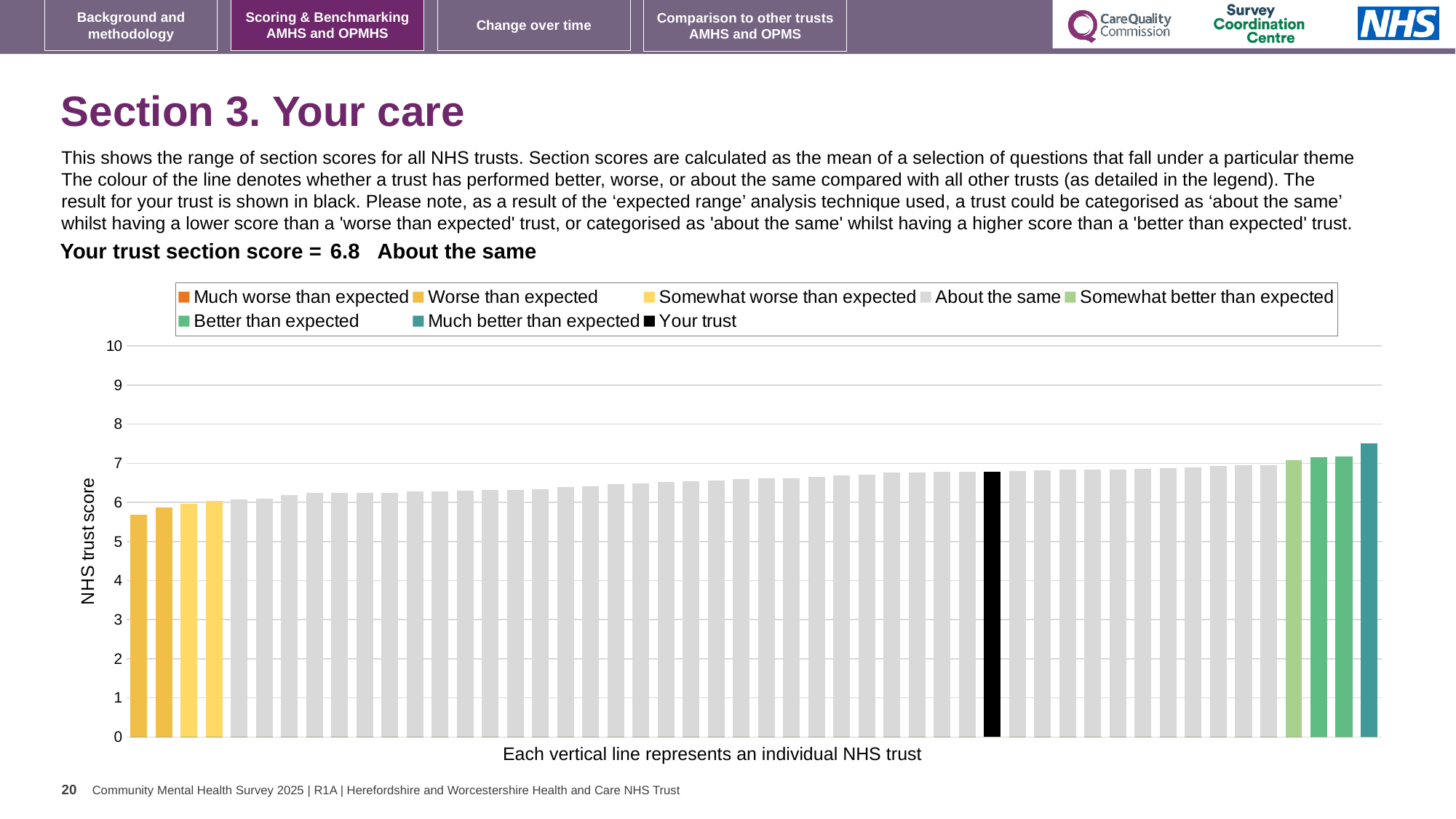
Do the bar values rise or fall from left to right along the x axis? rise What colour is the bar representing your trust? black How many entries does the chart legend list? 8 Is the value for your trust greater or less than 5? greater Which benchmarking category is your trust placed in for Section 3? About the same Is the value of the tallest bar greater or less than 7? greater Which legend category does the tallest bar belong to? Much better than expected What is the label on the vertical axis? NHS trust score What is the section score for your trust? 6.8 What kind of chart is shown on the slide? bar chart Is your trust's bar higher or lower than the tallest bar on the chart? lower Is the value of the lowest bar greater or less than 6? less